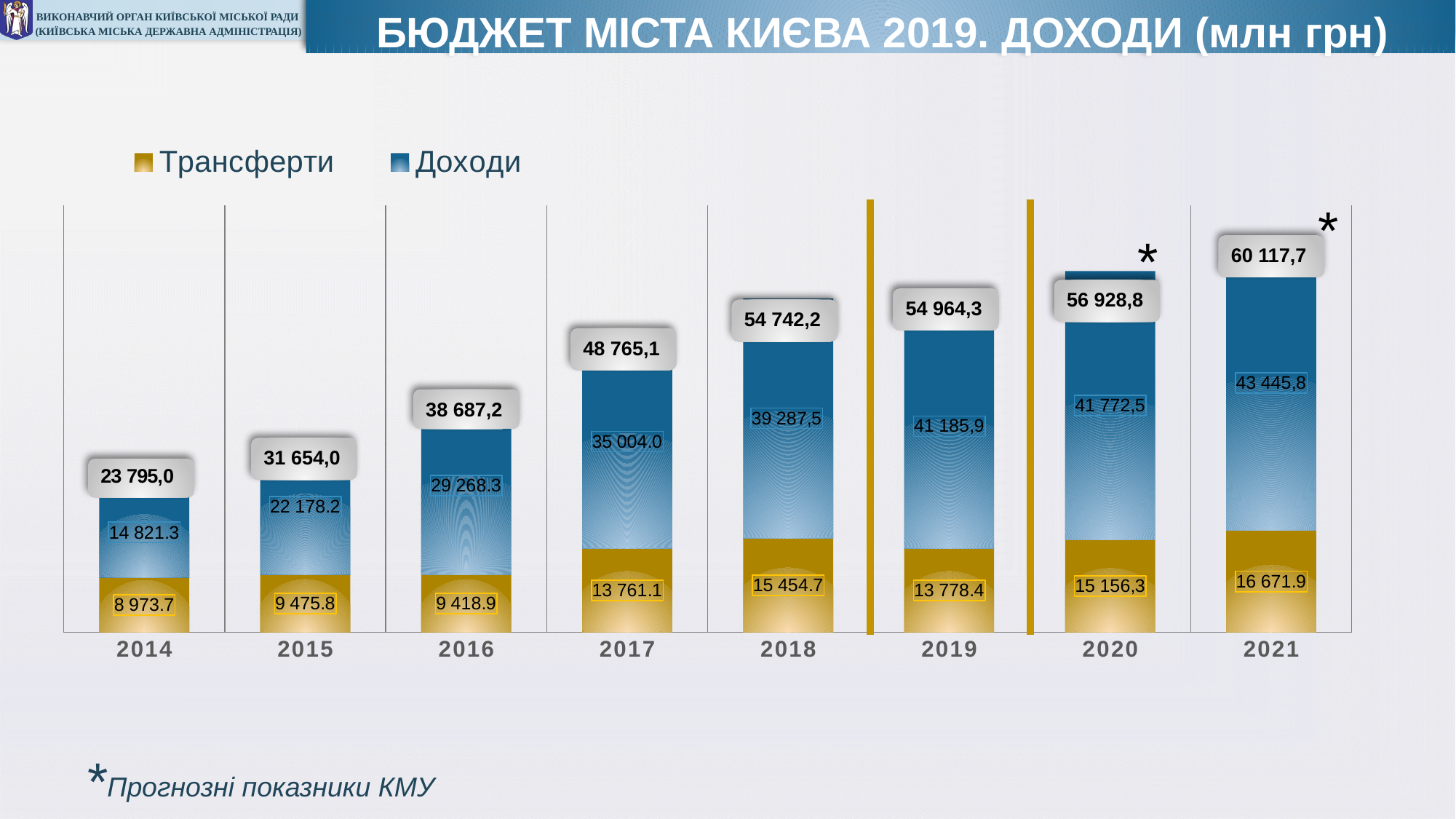
What is the value of Доходи for 2017? 35 004.0 Which years are marked with an asterisk as forecast indicators (Прогнозні показники КМУ)? 2020 and 2021 Which is larger: Доходи in 2019 or Доходи in 2018? Доходи in 2019 How many series does the legend list? 2 How many years are shown on the x axis? 8 What is the difference between the total for 2021 and the total for 2014? 36 322,7 Do the total values rise or fall from 2014 to 2021? Rise What type of chart is shown on the slide? Stacked bar chart What is the value of Трансферти for 2018? 15 454.7 Which year has the highest total budget revenue? 2021 Which year has the lowest value of Трансферти? 2014 What is the total of the stacked bar for 2019? 54 964,3